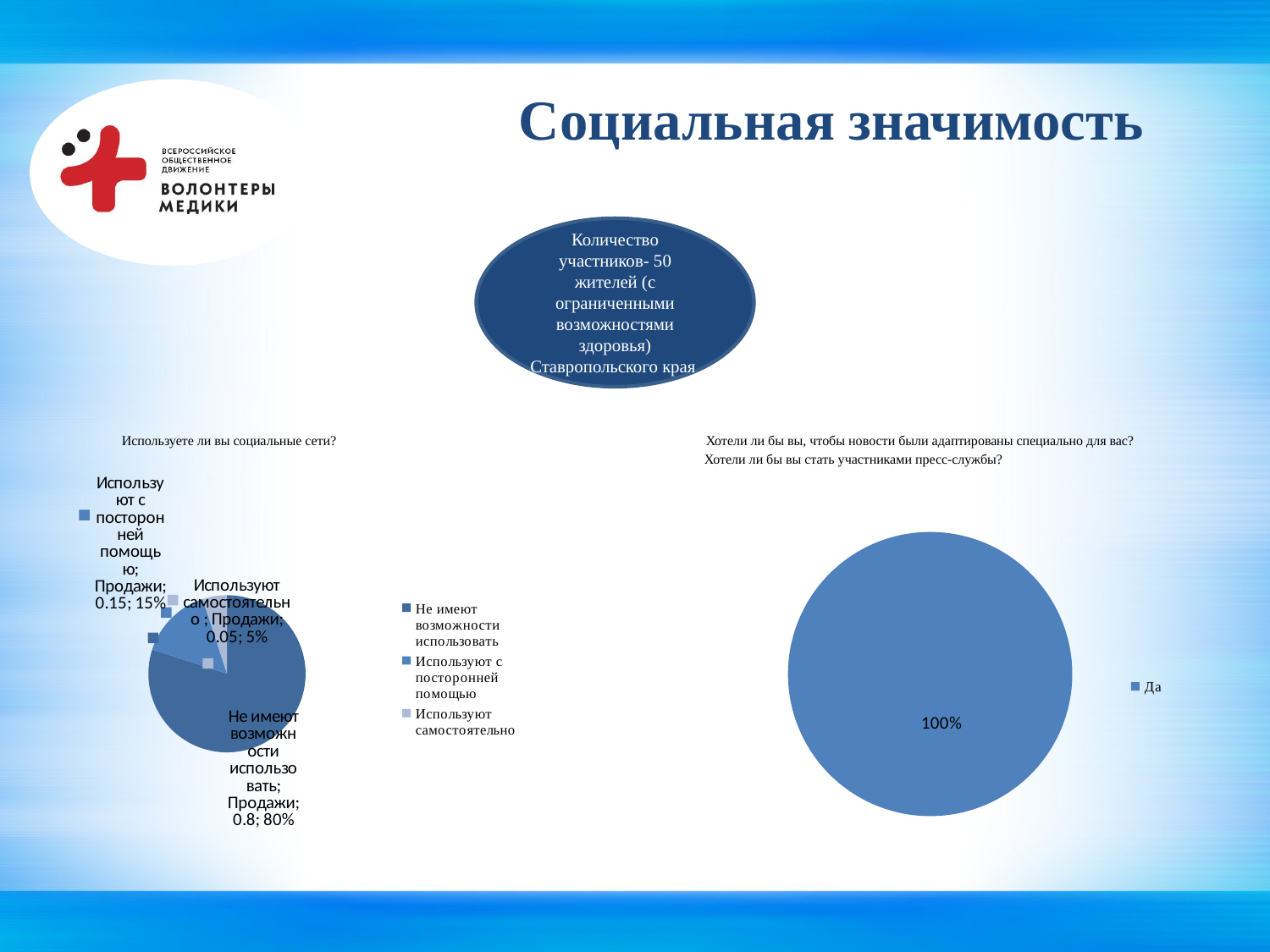
In the left pie chart ("Используете ли вы социальные сети?"), what share is labelled for "Используют самостоятельно"? 5% In the left pie chart ("Используете ли вы социальные сети?"), which is larger: "Используют с посторонней помощью" or "Используют самостоятельно"? Используют с посторонней помощью What type of chart is the left chart ("Используете ли вы социальные сети?")? Pie chart In the right pie chart, what percentage is labelled on the slice? 100% In the left pie chart ("Используете ли вы социальные сети?"), what share is labelled for "Используют с посторонней помощью"? 15% How many entries does the legend of the right pie chart list? 1 What is the only legend entry of the right pie chart? Да In the left pie chart ("Используете ли вы социальные сети?"), what is the difference in percentage points between "Не имеют возможности использовать" and "Используют с посторонней помощью"? 65 percentage points How many categories does the left pie chart ("Используете ли вы социальные сети?") show? 3 In the left pie chart ("Используете ли вы социальные сети?"), which category has the smallest slice? Используют самостоятельно In the left pie chart ("Используете ли вы социальные сети?"), which category has the largest slice? Не имеют возможности использовать